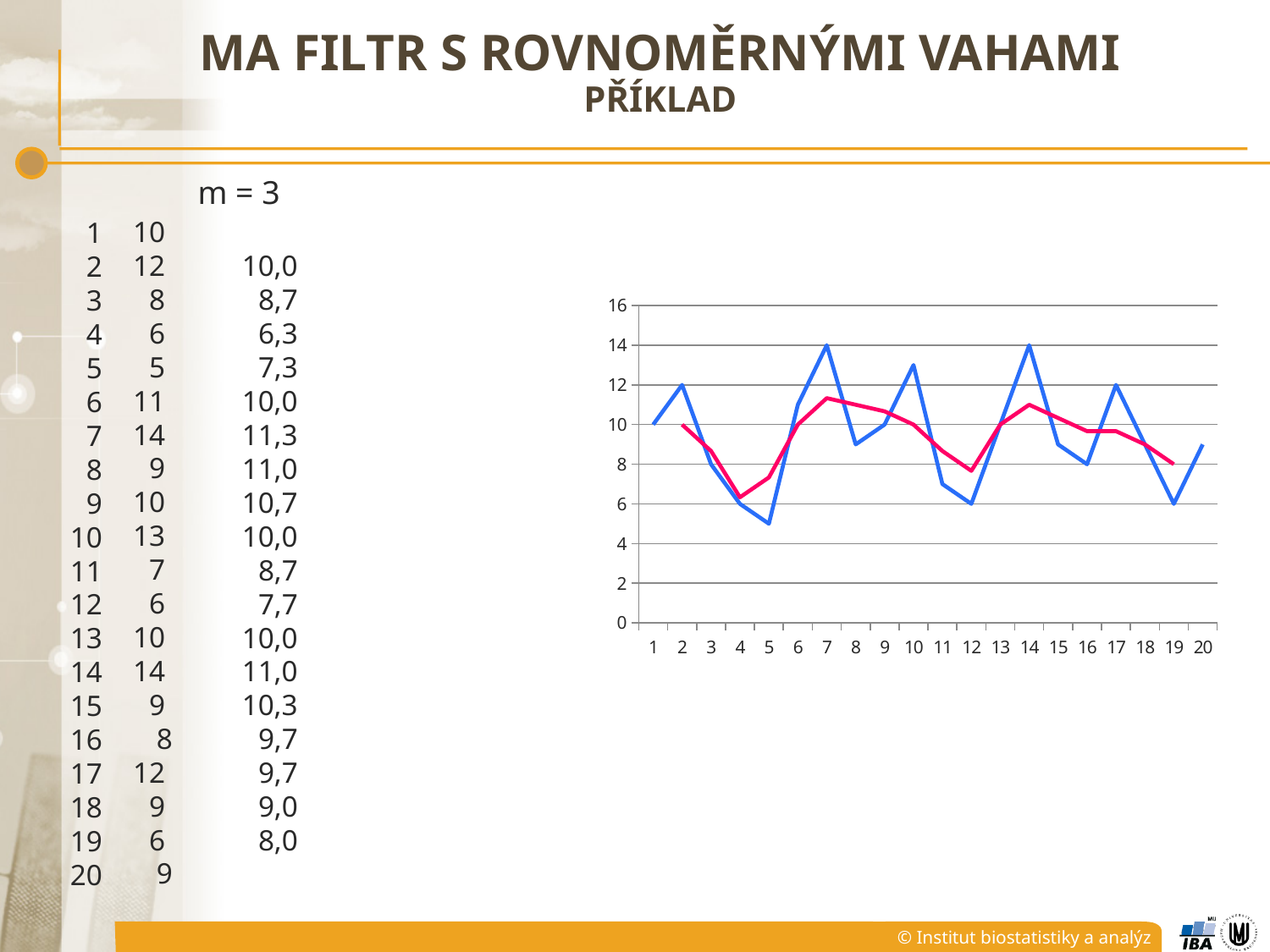
How many points are labelled along the x axis of the chart? 20 Which is larger for the blue line: the value at x = 10 or the value at x = 11? x = 10 At which x-axis point does the blue line reach its lowest value? 5 Is the value of the red line at x = 7 greater or less than 10? greater Does the blue line rise or fall between x = 2 and x = 5? fall Is the value of the red line at x = 4 greater or less than 8? less What is the value of the blue line at x = 5? 5 What is the highest value reached by the blue line? 14 How many lines are plotted in the chart? 2 What is the value of the blue line at x = 7? 14 What kind of chart is shown on the slide? line chart What is the difference between the blue line's value at x = 7 and its value at x = 5? 9